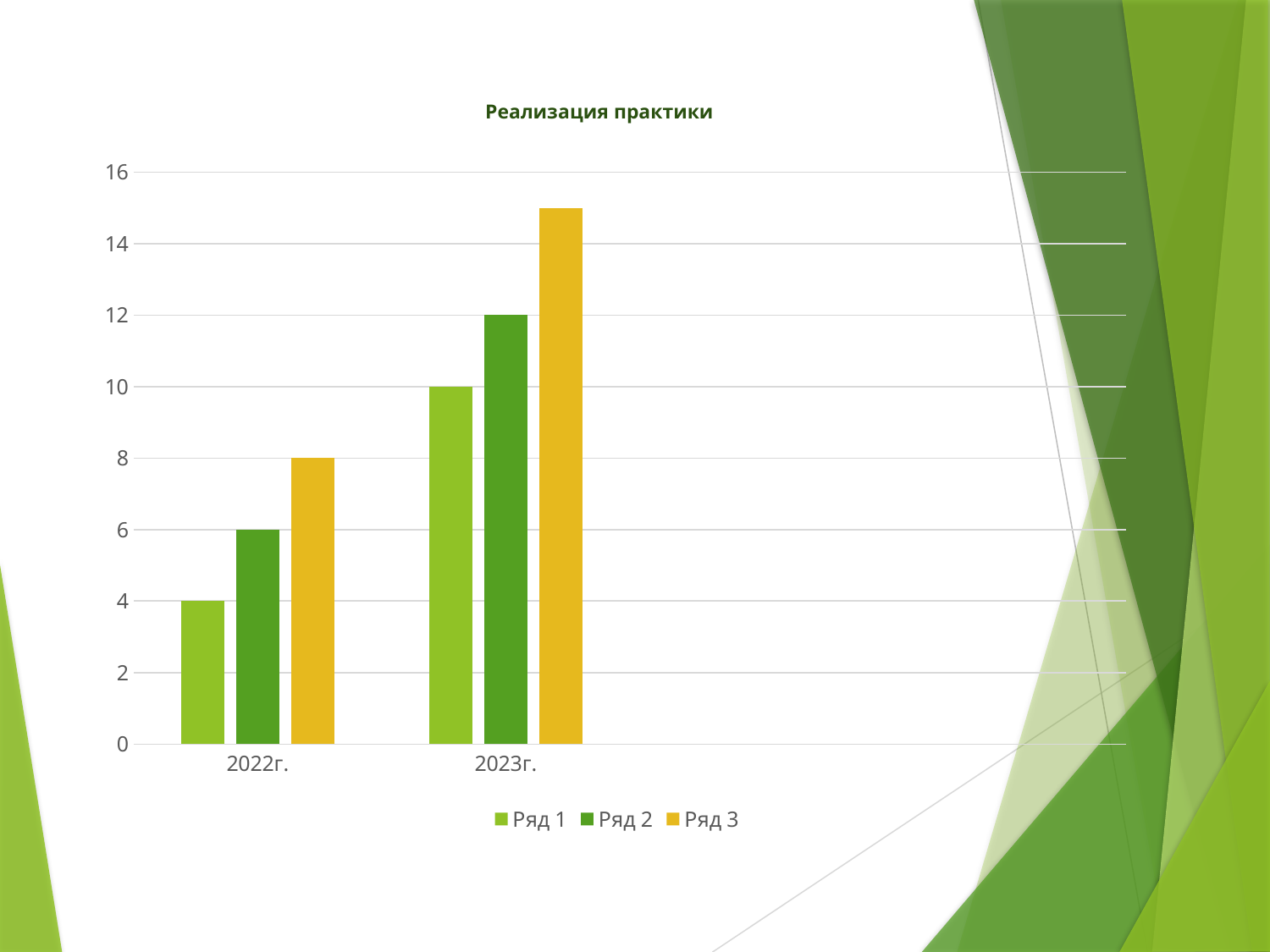
What is the value for Ряд 2 in 2022г.? 6 What kind of chart is shown on the slide? bar chart How many categories are shown on the x axis? 2 What is the value for Ряд 2 in 2023г.? 12 What is the value for Ряд 3 in 2022г.? 8 What is the value for Ряд 1 in 2023г.? 10 What is the value for Ряд 1 in 2022г.? 4 How many series does the legend list? 3 What is the title of the chart? Реализация практики Which series has the highest value in 2023г.? Ряд 3 Is the value for Ряд 3 in 2023г. greater or less than 14? greater What is the difference between Ряд 1 in 2023г. and Ряд 1 in 2022г.? 6